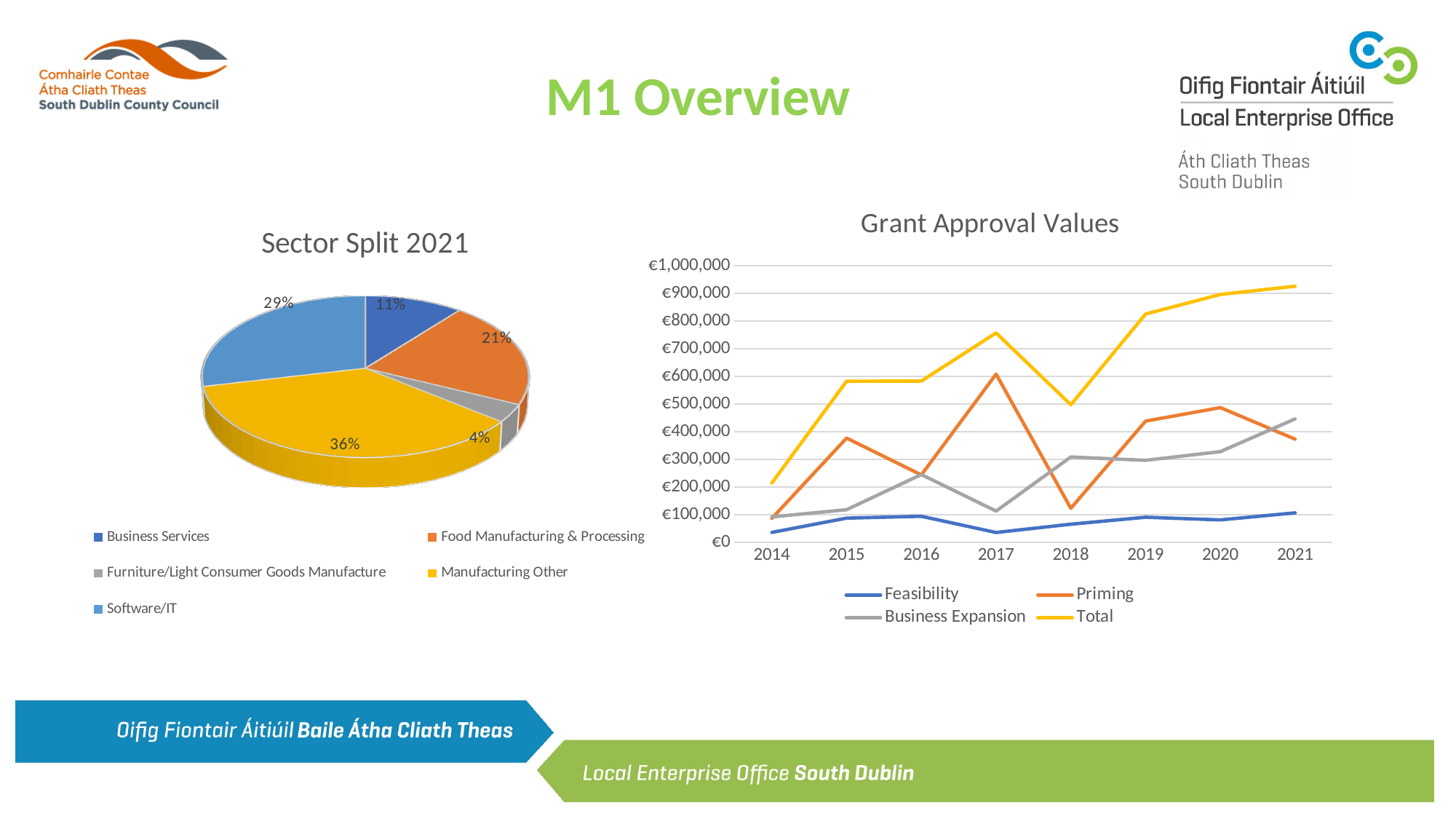
In the Grant Approval Values chart, is the Total value for 2021 greater or less than €900,000? greater In the Sector Split 2021 chart, how many sectors are shown? 5 In the Sector Split 2021 chart, what share does Software/IT have? 29% In the Grant Approval Values chart, how many years are shown on the x axis? 8 In the Sector Split 2021 chart, which sector has the smallest share? Furniture/Light Consumer Goods Manufacture In the Grant Approval Values chart, which series has the highest value in 2017, Priming or Business Expansion? Priming In the Grant Approval Values chart, how many series does the legend list? 4 In the Sector Split 2021 chart, what share does Business Services have? 11% What kind of chart is the Sector Split 2021 chart? Pie chart In the Sector Split 2021 chart, what is the difference in percentage points between Food Manufacturing & Processing and Business Services? 10 In the Sector Split 2021 chart, what share does Manufacturing Other have? 36% In the Sector Split 2021 chart, which sector has the largest share? Manufacturing Other